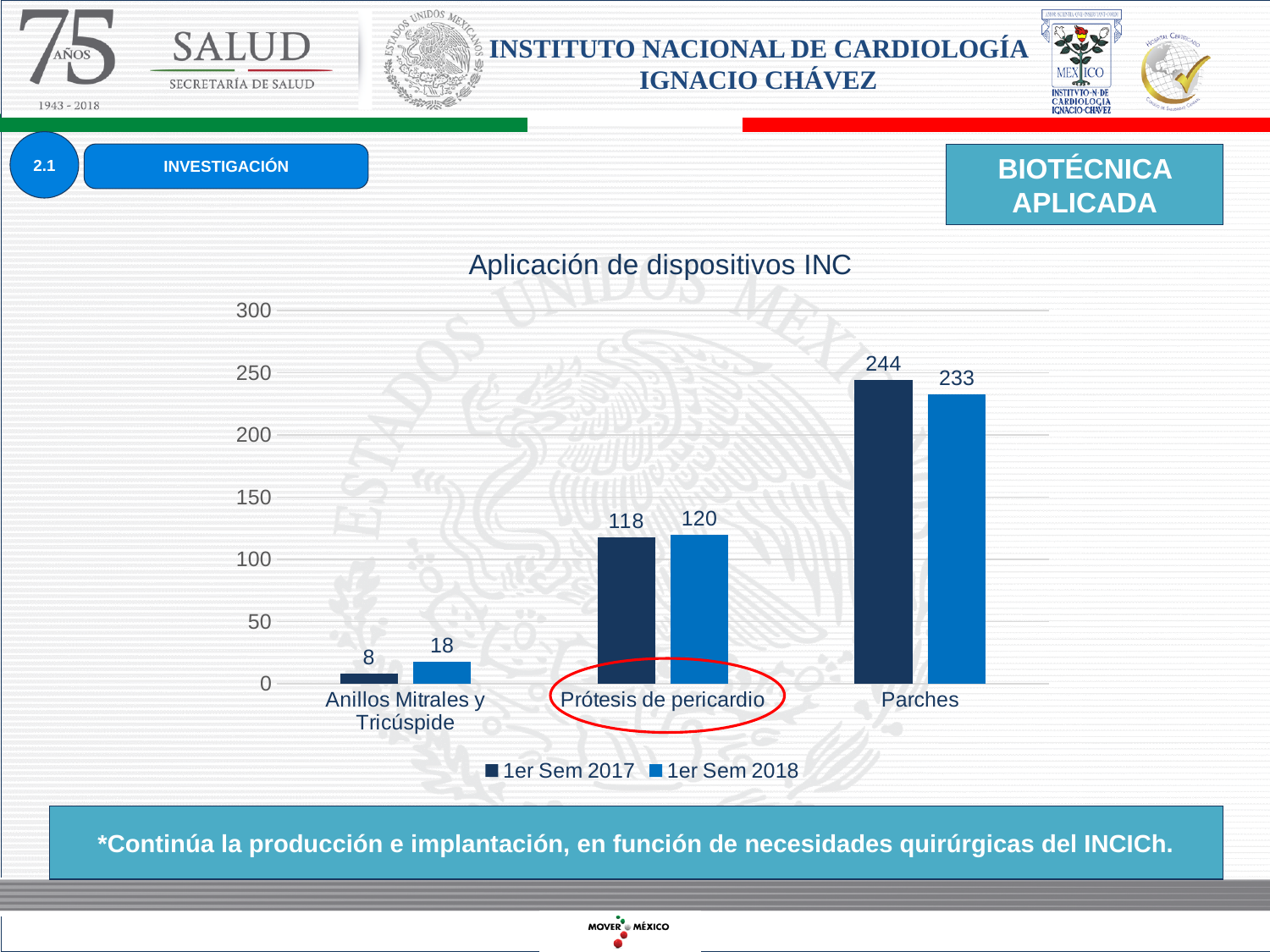
How many series does the legend list? 2 For Prótesis de pericardio, which is larger: 1er Sem 2017 or 1er Sem 2018? 1er Sem 2018 What is the value for Anillos Mitrales y Tricúspide in 1er Sem 2017? 8 What is the value for Prótesis de pericardio in 1er Sem 2018? 120 What is the title of the chart? Aplicación de dispositivos INC How many categories are shown on the x axis? 3 What is the difference between the 1er Sem 2017 and 1er Sem 2018 values for Parches? 11 Which category has the highest value in 1er Sem 2018? Parches What kind of chart is shown? Bar chart What is the difference between the 1er Sem 2018 and 1er Sem 2017 values for Anillos Mitrales y Tricúspide? 10 What is the value for Parches in 1er Sem 2017? 244 Which category has the lowest value in 1er Sem 2017? Anillos Mitrales y Tricúspide